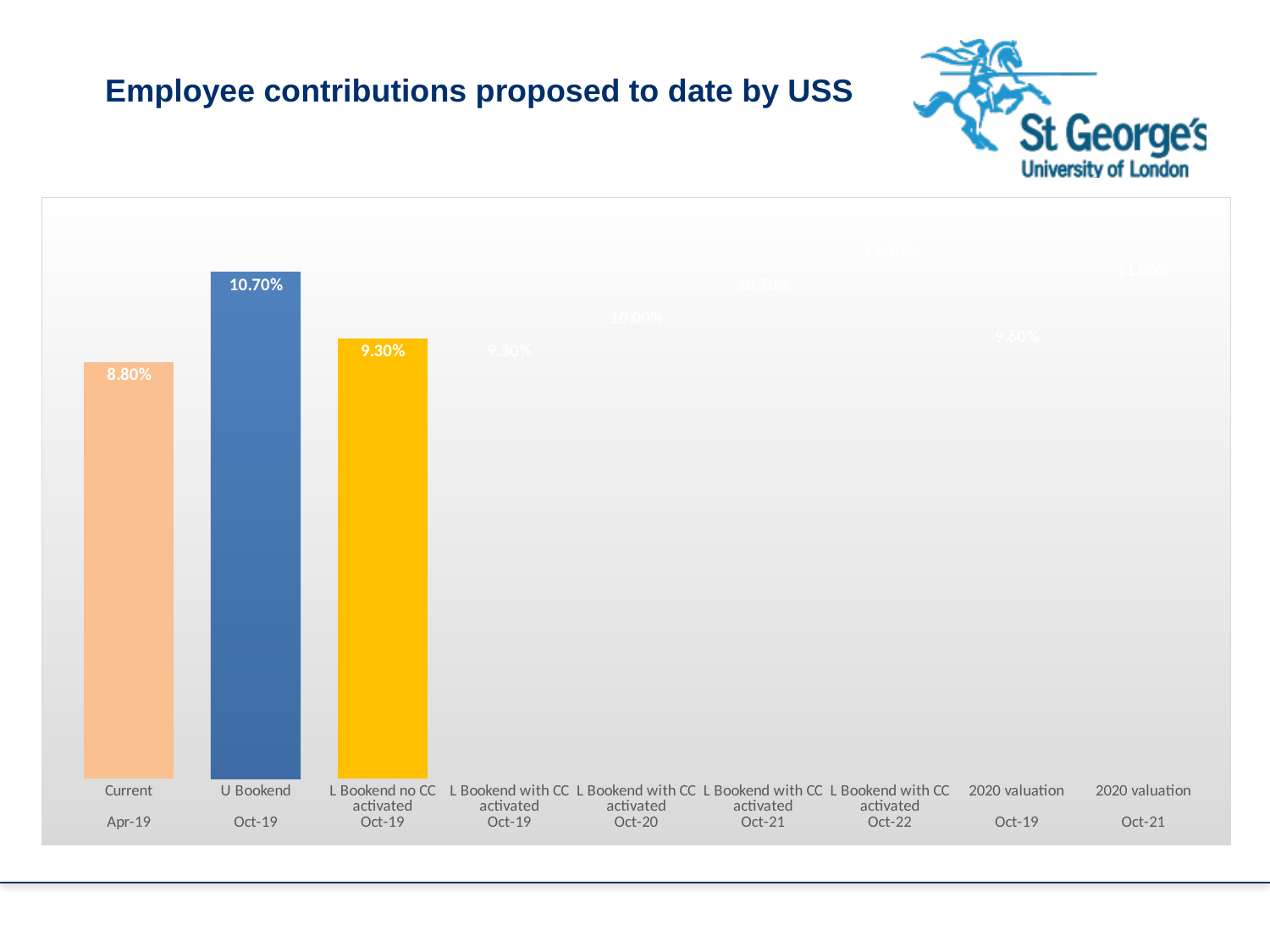
How many categories are labelled along the x axis? 9 What is the title of the slide? Employee contributions proposed to date by USS Which is larger, the value for U Bookend or the value for L Bookend no CC activated? U Bookend Among the bars with visible data labels, which category has the highest value? U Bookend What is the value for L Bookend no CC activated (Oct-19)? 9.30% What is the difference between the U Bookend value and the Current value? 1.90% What colour is the bar for U Bookend? Blue What is the difference between the L Bookend no CC activated value and the Current value? 0.50% Among the bars with visible data labels, which category has the lowest value? Current What is the value for U Bookend (Oct-19)? 10.70% What is the value for Current (Apr-19)? 8.80% What kind of chart is shown on the slide? Bar chart